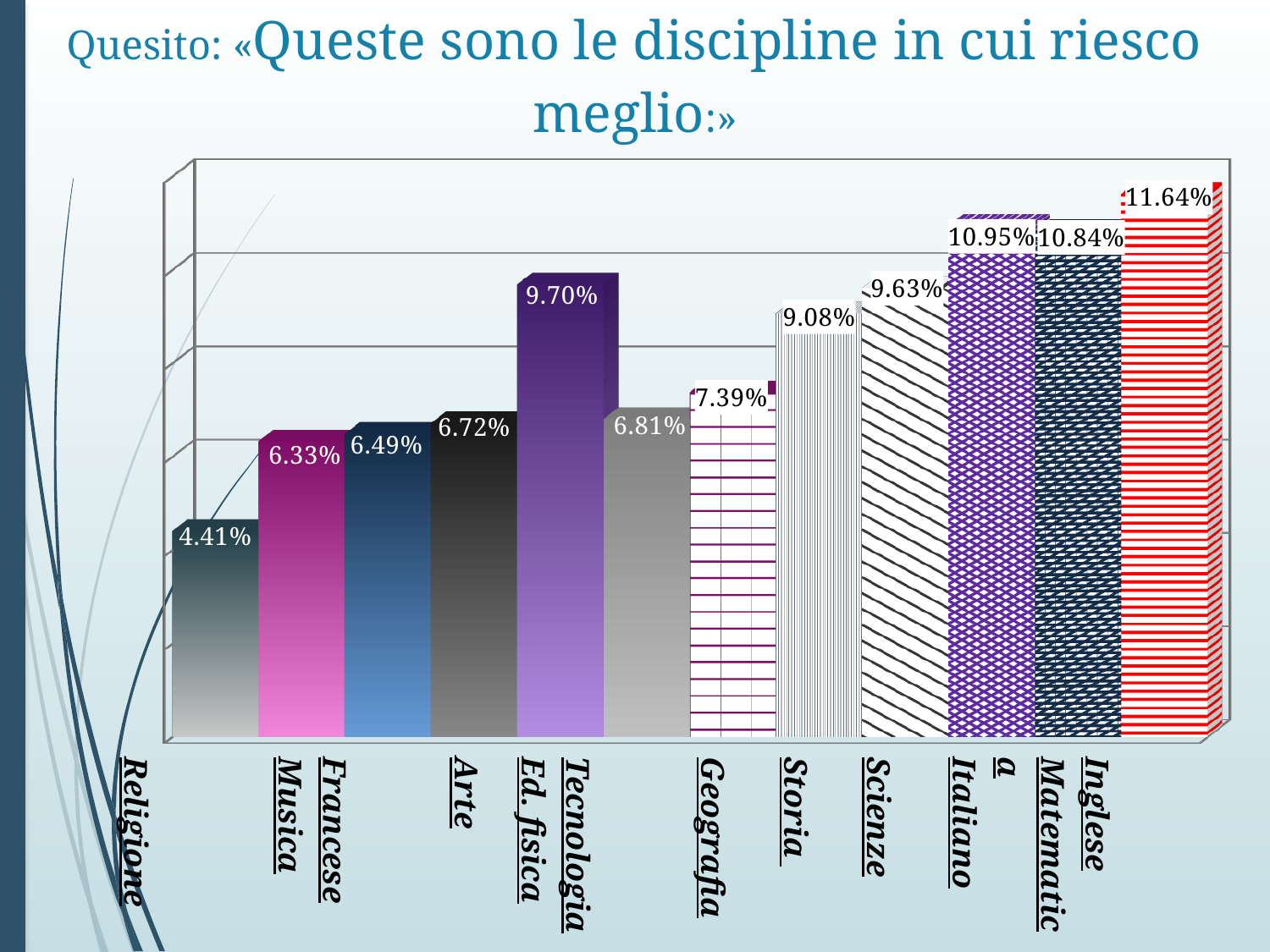
Which has a larger value, Storia or Scienze? Scienze What is the difference between the values for Italiano and Matematica? 0.11% What is the value for Matematica? 10.84% Which discipline has the highest percentage? Inglese What percentage is shown for Tecnologia? 6.81% Which has a larger value, Italiano or Matematica? Italiano What kind of chart is shown on the slide? Bar chart Which discipline has the lowest percentage? Religione What percentage is shown for Religione? 4.41% How many disciplines are shown in the chart? 12 What is the value for Ed. fisica? 9.70% What is the difference between the values for Inglese and Religione? 7.23%